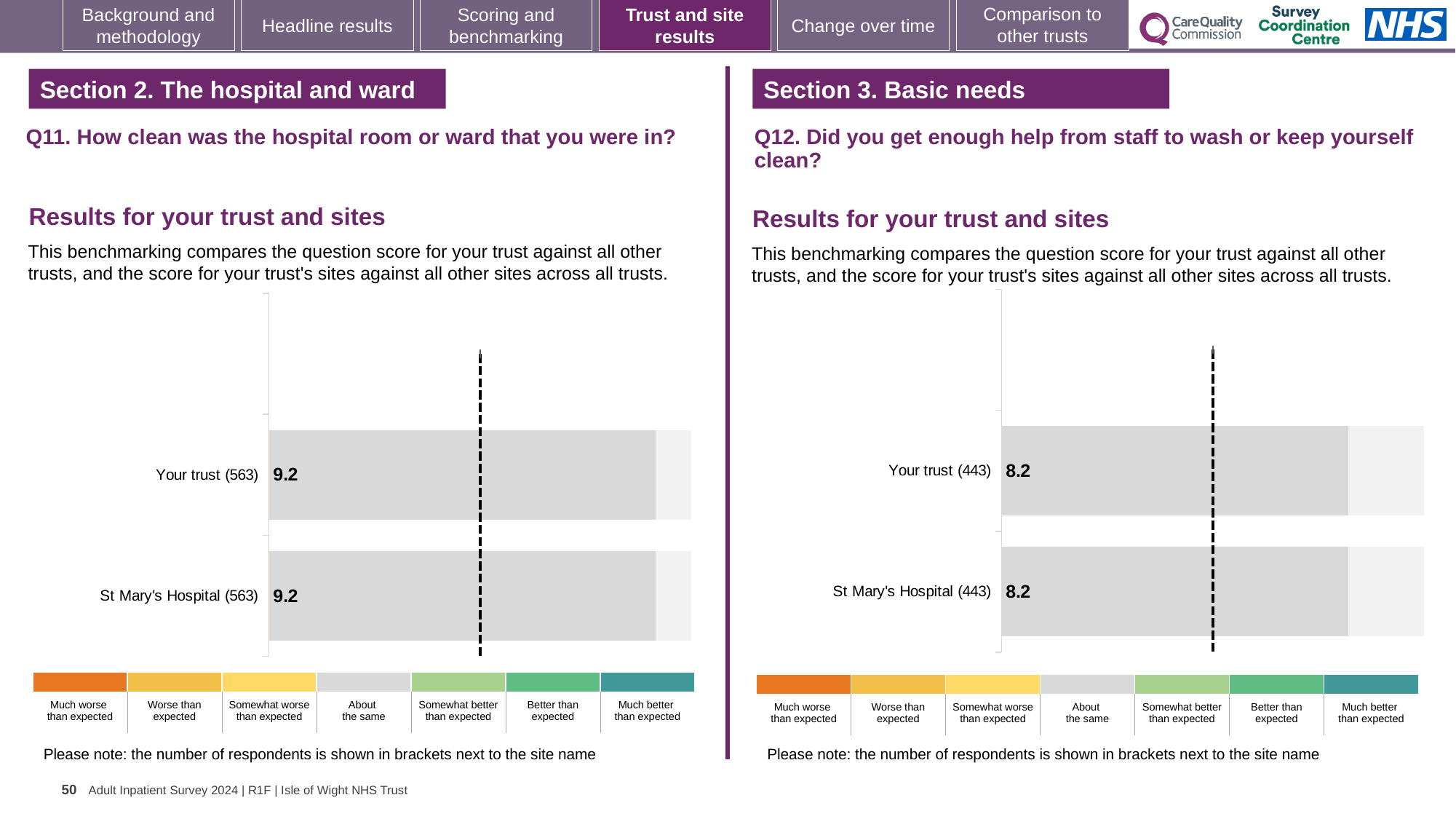
How many categories does the colour key below the Q11 chart (left) list? 7 In the Q11 chart (left), what is the score for St Mary's Hospital? 9.2 Is the Your trust score in the Q11 chart (left) larger or smaller than the Your trust score in the Q12 chart (right)? Larger In the Q11 chart (left), what is the score for Your trust? 9.2 In the Q12 chart (right), what is the score for St Mary's Hospital? 8.2 In the Q12 chart (right), how many bars are plotted? 2 What kind of chart is the Q11 chart (left)? Bar chart In the Q11 chart (left), how many respondents are shown in brackets for Your trust? 563 In the Q12 chart (right), how many respondents are shown in brackets for St Mary's Hospital? 443 In the Q12 chart (right), what is the score for Your trust? 8.2 In the Q11 chart (left), what is the difference between the scores for Your trust and St Mary's Hospital? 0.0 In the Q12 chart (right), which category does the colour key label for the grey band represent? About the same